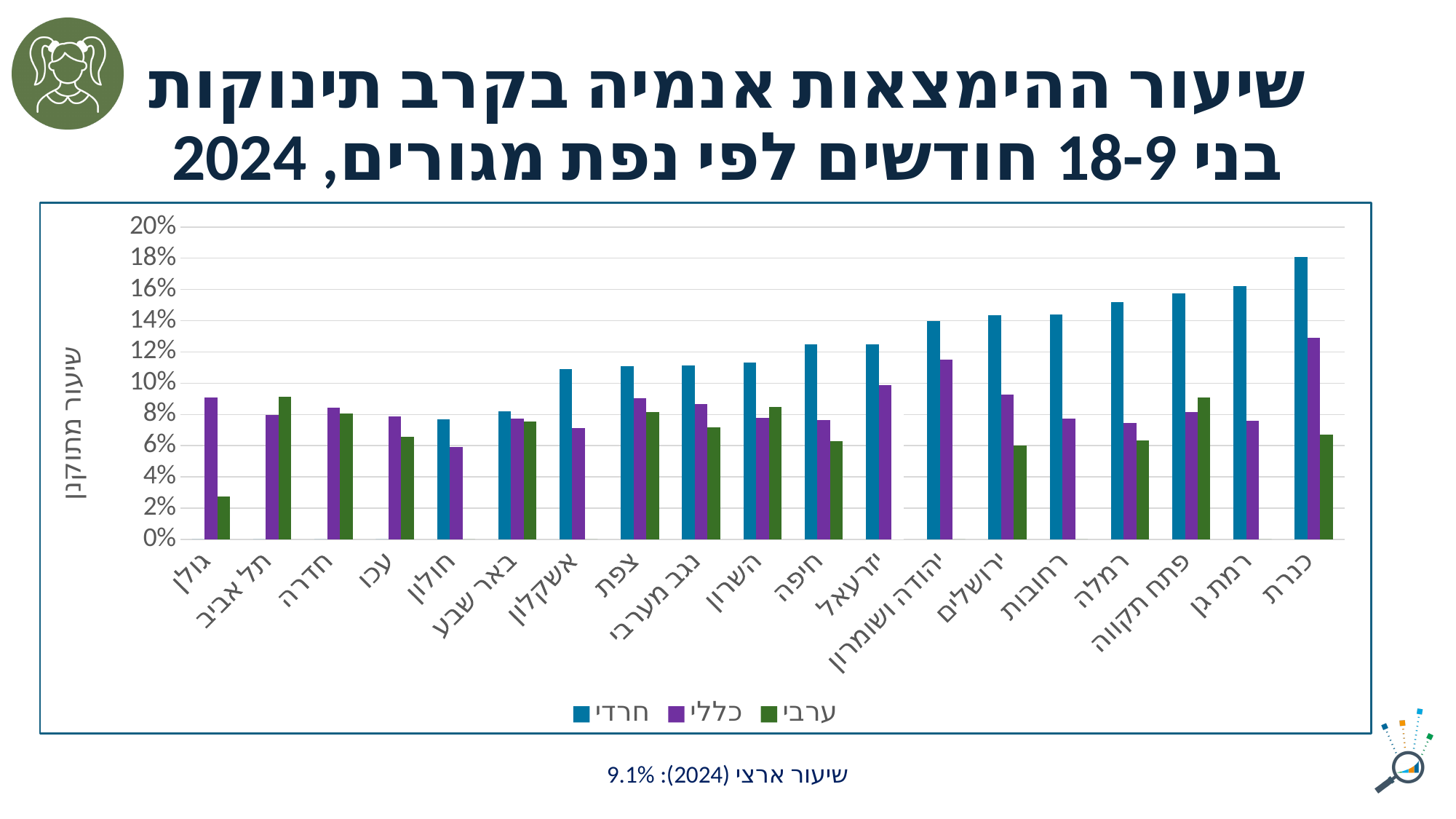
Is the ערבי value for גולן greater or less than 4%? less Is the חרדי value for כנרת greater or less than 16%? greater In תל אביב, which is larger: the כללי value or the ערבי value? ערבי Which district has the highest value for the כללי series? כנרת Which district has the highest value for the חרדי series? כנרת Do the חרדי values generally rise or fall moving from left to right along the x axis? rise How many series does the legend list? 3 Which series is shown in blue in the legend? חרדי Is the כללי value for יהודה ושומרון greater or less than 10%? greater What kind of chart is shown on the slide? bar chart How many districts (categories) are shown on the x axis? 19 Which district has the lowest value for the ערבי series? גולן